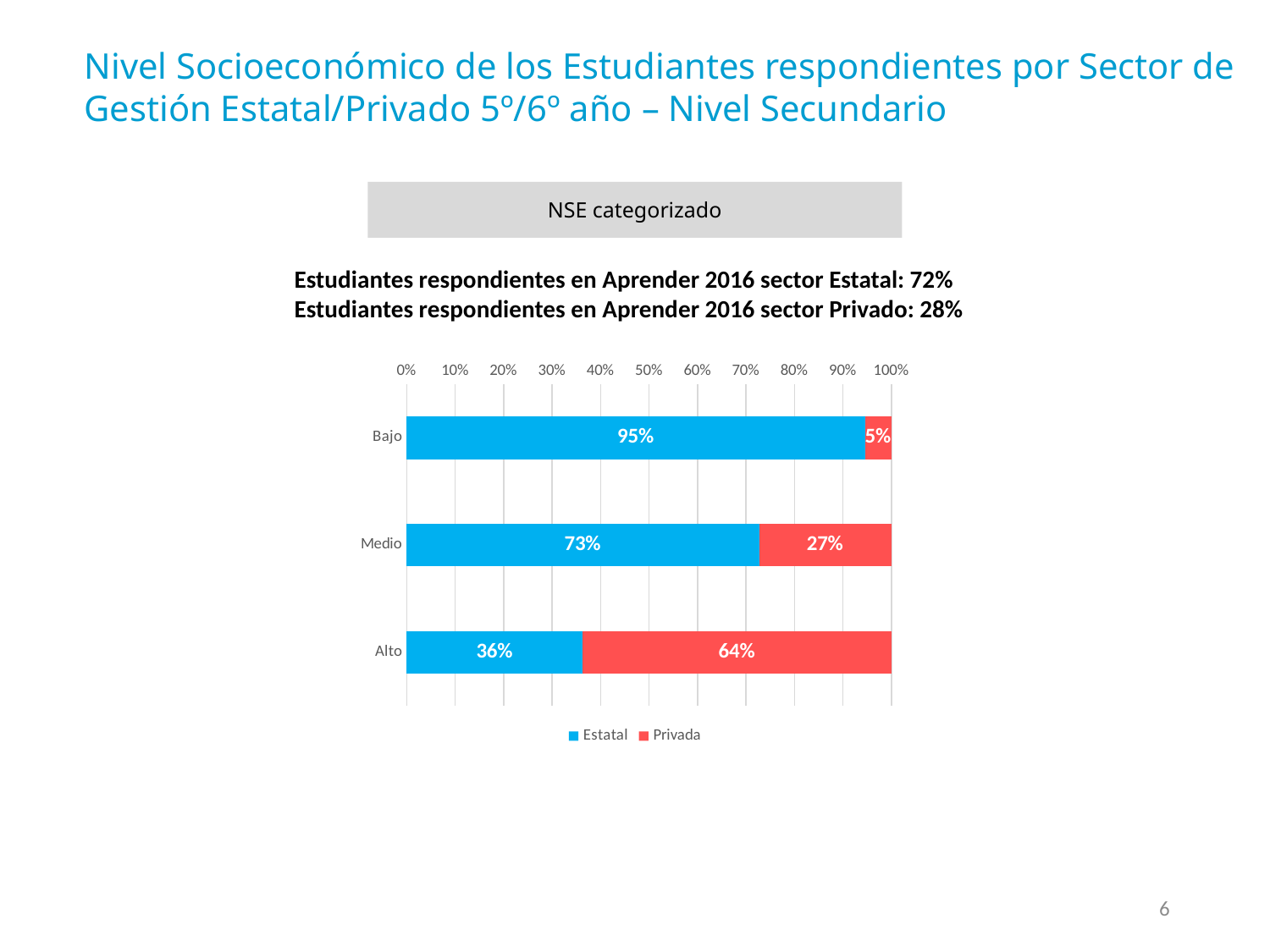
How many categories are shown on the chart? 3 What is the Estatal value for the Medio category? 73% What is the total of the stacked bar for Medio? 100% What is the difference between the Estatal values for Bajo and Alto? 59% What is the Estatal value for the Bajo category? 95% What kind of chart is shown on the slide? Stacked bar chart What is the Privada value for the Alto category? 64% Which category has the lowest Privada value? Bajo Which is larger: the Privada value for Alto or the Privada value for Medio? Alto What is the Privada value for the Medio category? 27% How many series does the legend list? 2 Which category has the highest Estatal value? Bajo